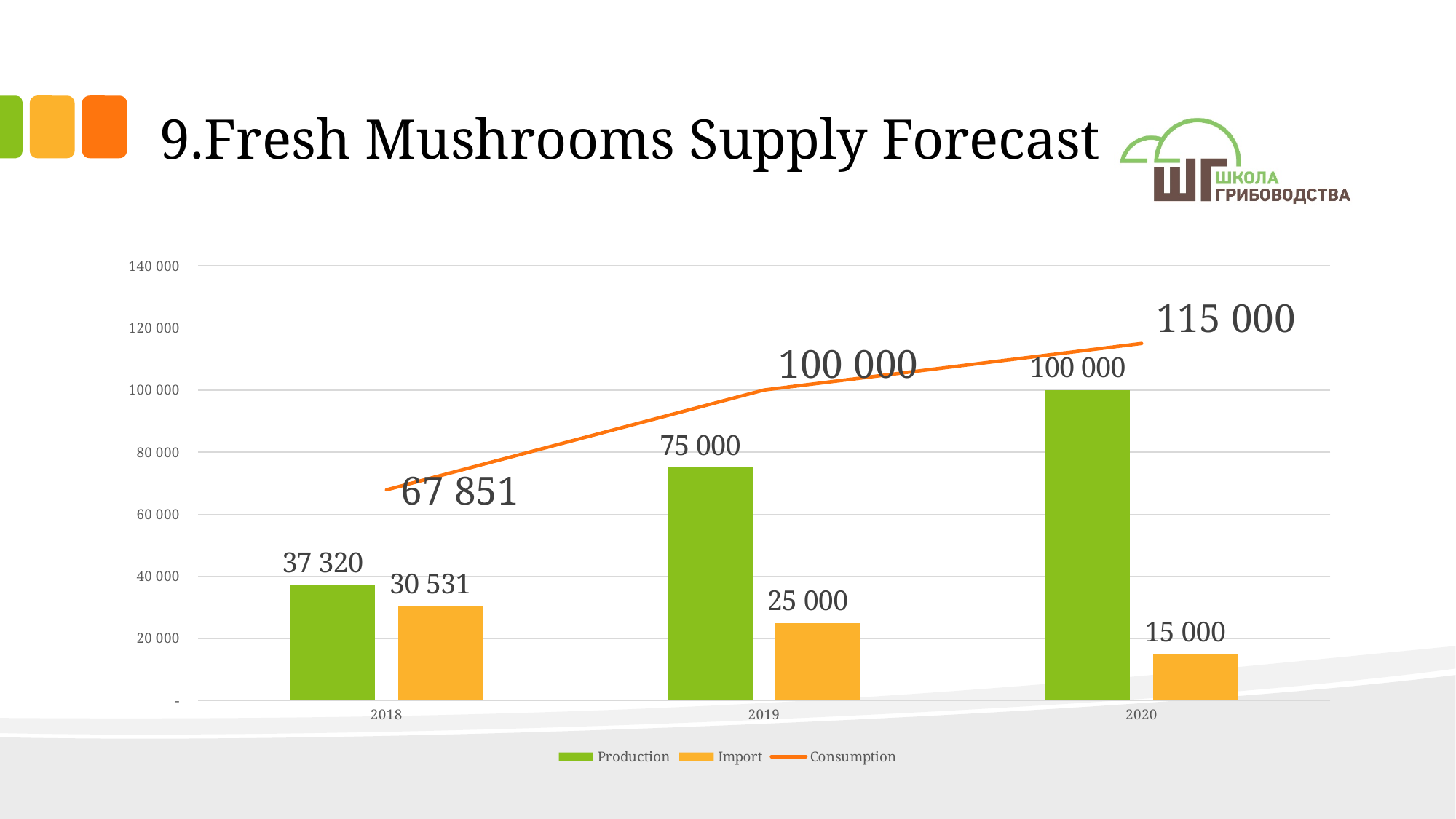
Is the Consumption value for 2018 greater or less than 60 000? greater What is the Import value for 2018? 30 531 What is the Consumption value for 2020? 115 000 What is the Production value for 2019? 75 000 Which is larger in 2018, Production or Import? Production Which year has the highest Production value? 2020 Does the Import value rise or fall from 2018 to 2020? fall How many years are shown on the x axis? 3 Which year has the lowest Import value? 2020 What is the difference between Production and Import in 2020? 85 000 How many series does the legend list? 3 Which series is drawn as a line rather than bars? Consumption